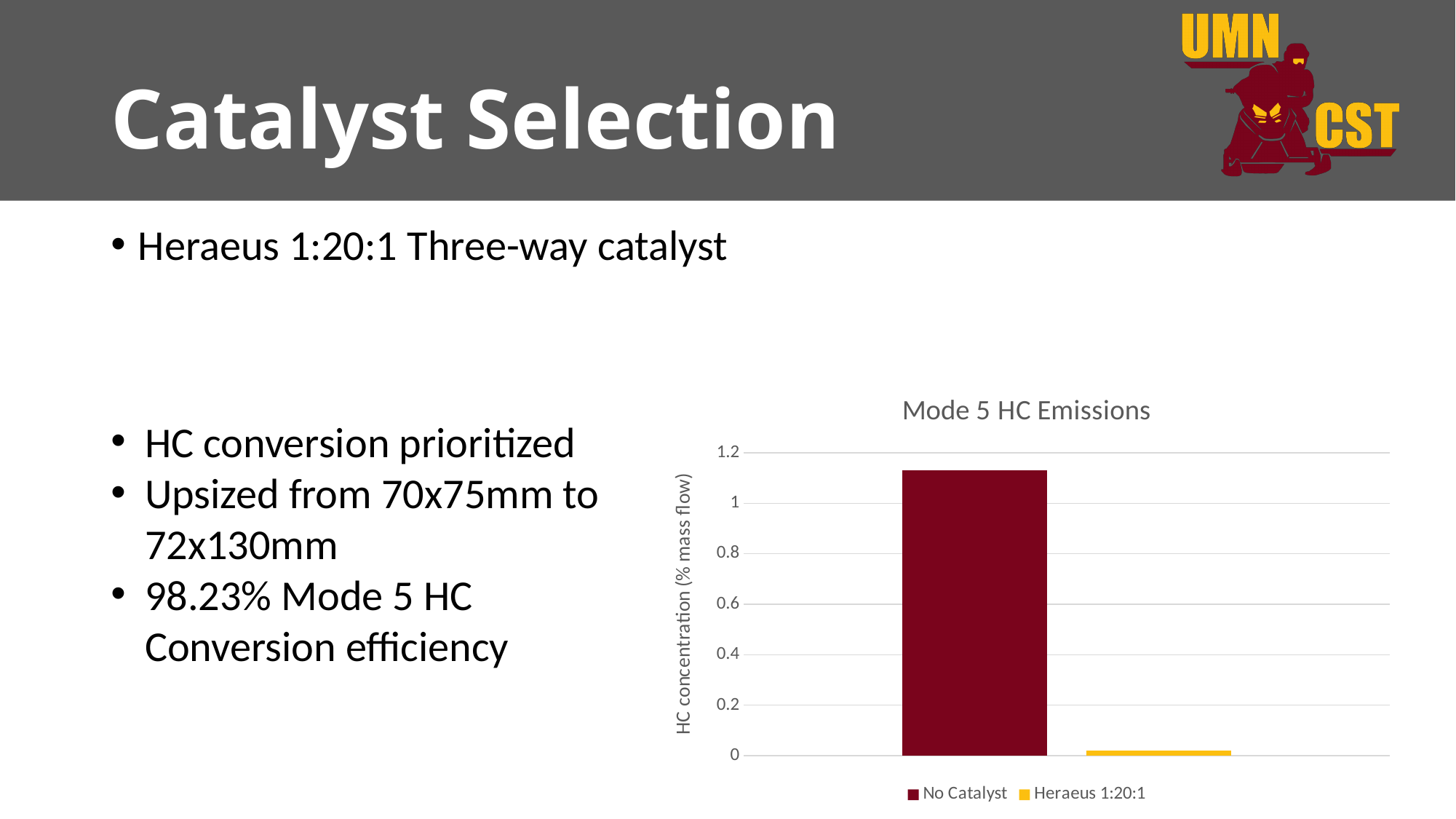
How many series does the chart legend list? 2 Which series has the lowest HC concentration in the chart? Heraeus 1:20:1 Is the value for Heraeus 1:20:1 greater or less than 0.2? less Is the value for No Catalyst greater or less than 1? greater Which series has the highest HC concentration in the chart? No Catalyst Is the value for No Catalyst greater or less than 1.2? less Which is larger, the HC concentration for No Catalyst or for Heraeus 1:20:1? No Catalyst What kind of chart is shown on the slide? bar chart How many bars are plotted in the chart? 2 What is the label of the vertical axis of the chart? HC concentration (% mass flow) What is the title of the chart? Mode 5 HC Emissions